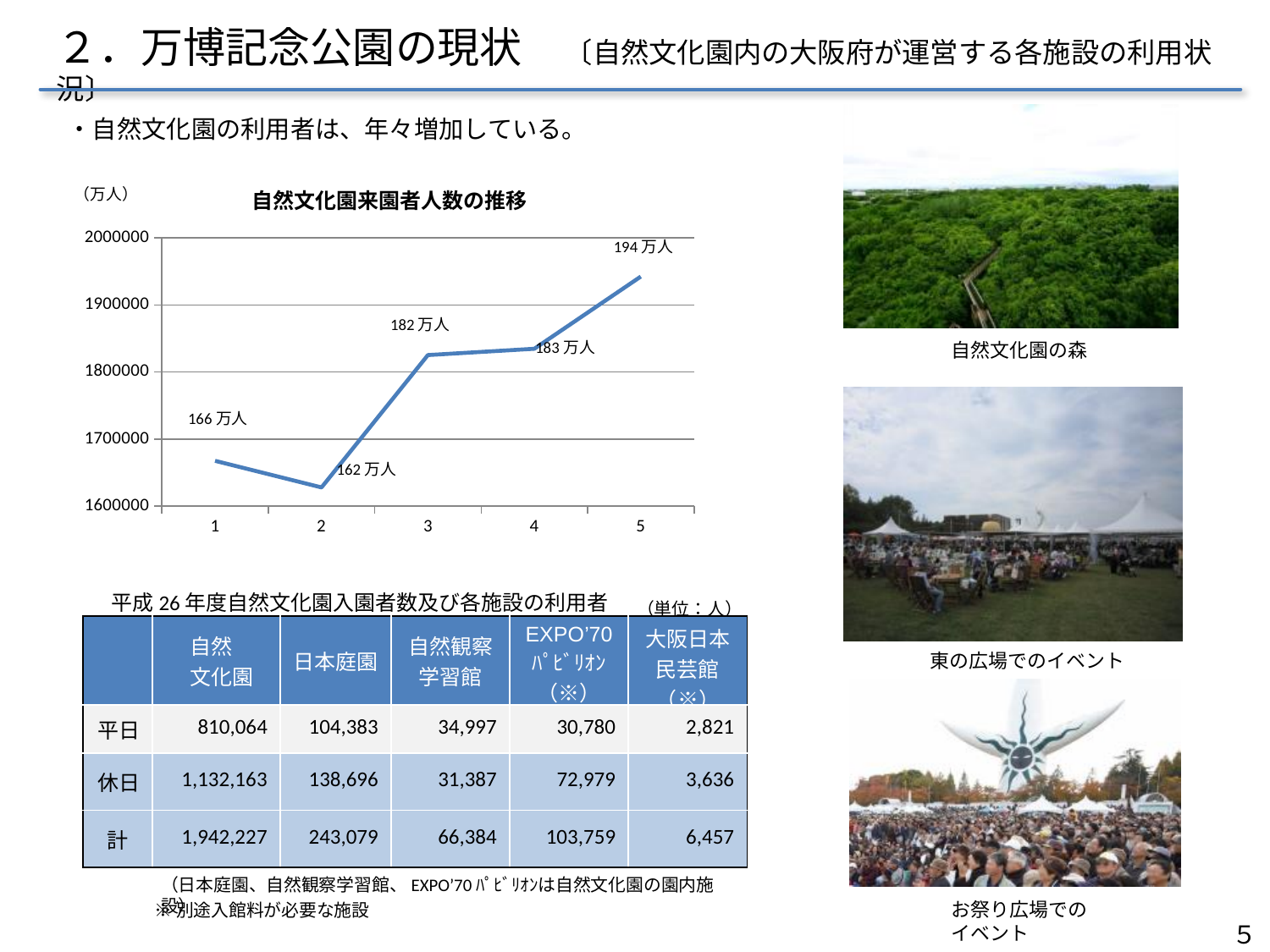
What is the value shown for point 5 on the line chart? 194 万人 Which point on the x axis has the lowest value in the line chart? 2 What is the title of the chart on the slide? 自然文化園来園者人数の推移 What kind of chart is 自然文化園来園者人数の推移? line chart How many data points are plotted on the line chart? 5 What is the difference between the values at point 5 and point 1 on the line chart? 28 万人 What is the value shown for point 3 on the line chart? 182 万人 What is the value shown for point 2 on the line chart? 162 万人 What is the value shown for point 1 on the line chart 自然文化園来園者人数の推移? 166 万人 Which has the larger value on the line chart, point 1 or point 3? point 3 Which point on the x axis has the highest value in the line chart? 5 Is the value at point 5 on the line chart greater or less than 1900000? greater